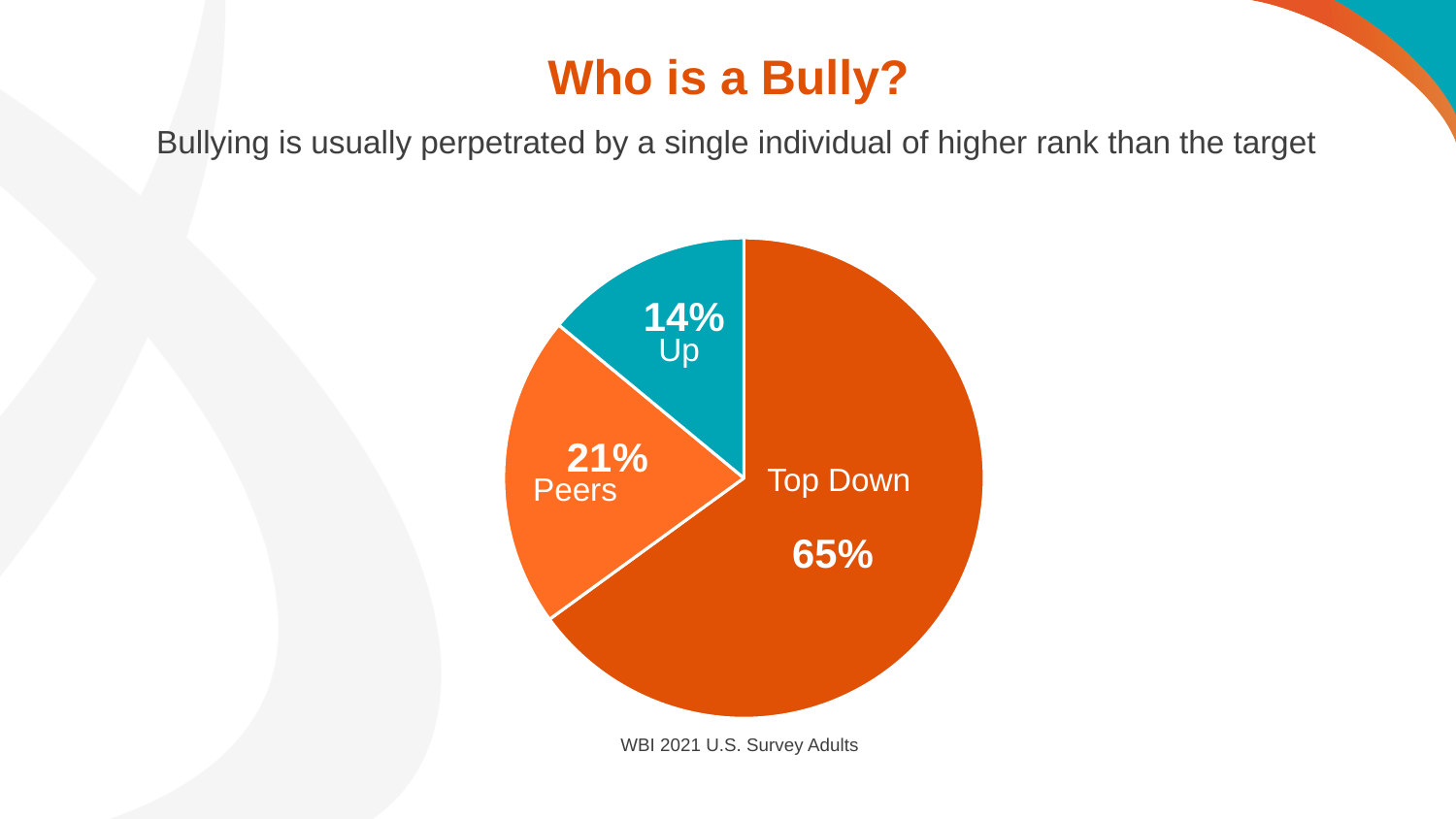
What is the difference in percentage points between Top Down and Peers? 44 How many slices does the pie chart have? 3 What percentage of bullying comes from Peers? 21% What colour is the Up slice of the pie chart? teal What kind of chart is shown on the slide? pie chart What percentage of bullying is Up? 14% What percentage of bullying is Top Down? 65% Which is larger, the share for Peers or the share for Up? Peers Which category has the largest share of the pie? Top Down Which category has the smallest share of the pie? Up What is the difference in percentage points between Peers and Up? 7 What is the source cited below the pie chart? WBI 2021 U.S. Survey Adults